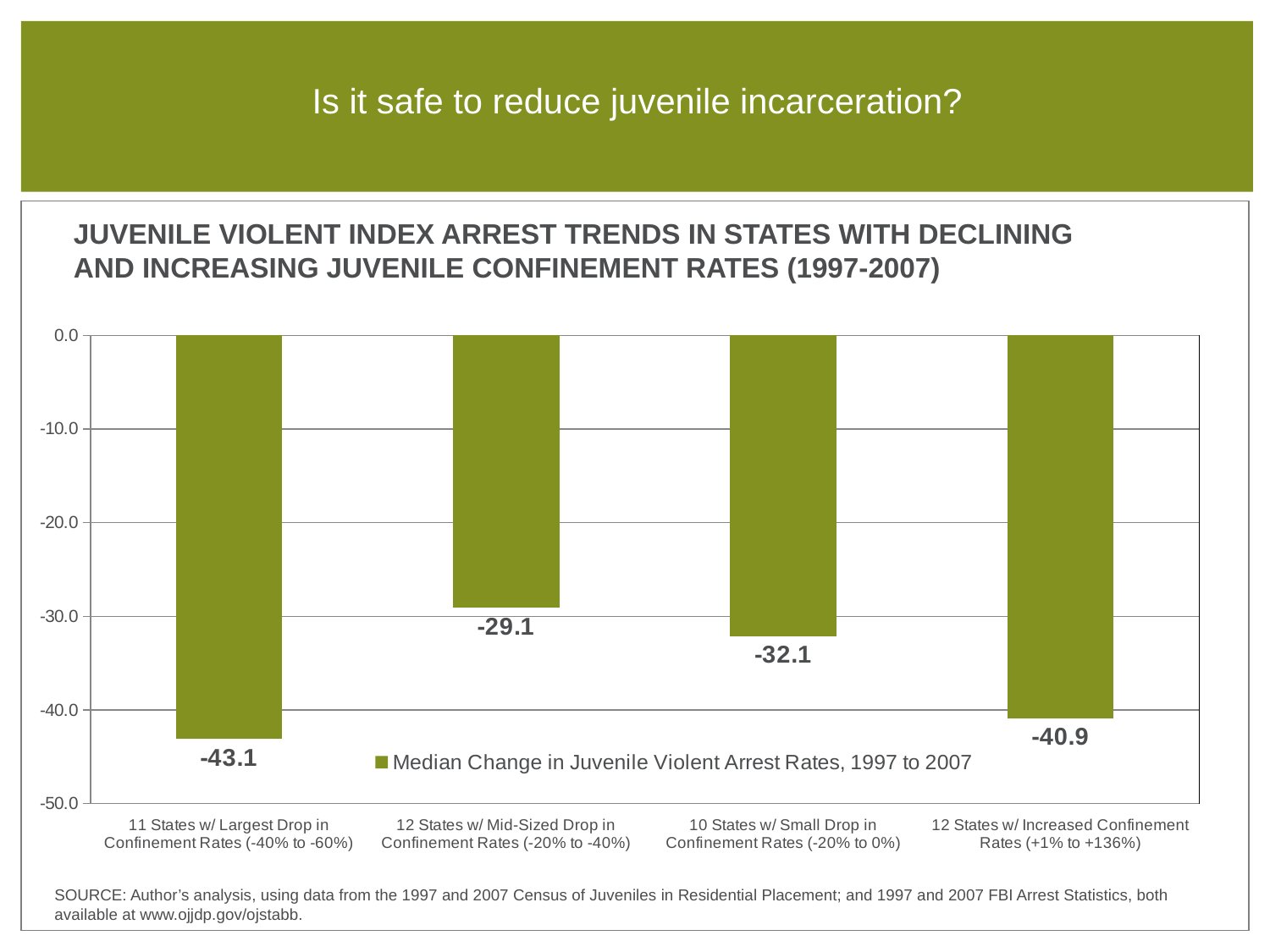
Which group of states shows the smallest decline (least negative value) in juvenile violent arrest rates? 12 States w/ Mid-Sized Drop in Confinement Rates (-20% to -40%) What is the median change in juvenile violent arrest rates for the 10 States w/ Small Drop in Confinement Rates (-20% to 0%)? -32.1 Which group of states shows the largest decline (most negative value) in juvenile violent arrest rates? 11 States w/ Largest Drop in Confinement Rates (-40% to -60%) What is the median change in juvenile violent arrest rates for the 11 States w/ Largest Drop in Confinement Rates (-40% to -60%)? -43.1 What is the median change in juvenile violent arrest rates for the 12 States w/ Mid-Sized Drop in Confinement Rates (-20% to -40%)? -29.1 Which group has a larger decline in juvenile violent arrest rates: the 10 States w/ Small Drop in Confinement Rates or the 12 States w/ Mid-Sized Drop in Confinement Rates? 10 States w/ Small Drop in Confinement Rates (-20% to 0%) How many groups of states are shown on the chart? 4 What is the median change in juvenile violent arrest rates for the 12 States w/ Increased Confinement Rates (+1% to +136%)? -40.9 What is the difference between the values for the 11 States w/ Largest Drop in Confinement Rates and the 12 States w/ Increased Confinement Rates? 2.2 How many data series does the legend list? 1 What type of chart is shown on the slide? Bar chart What is the difference between the values for the 10 States w/ Small Drop in Confinement Rates and the 12 States w/ Mid-Sized Drop in Confinement Rates? 3.0